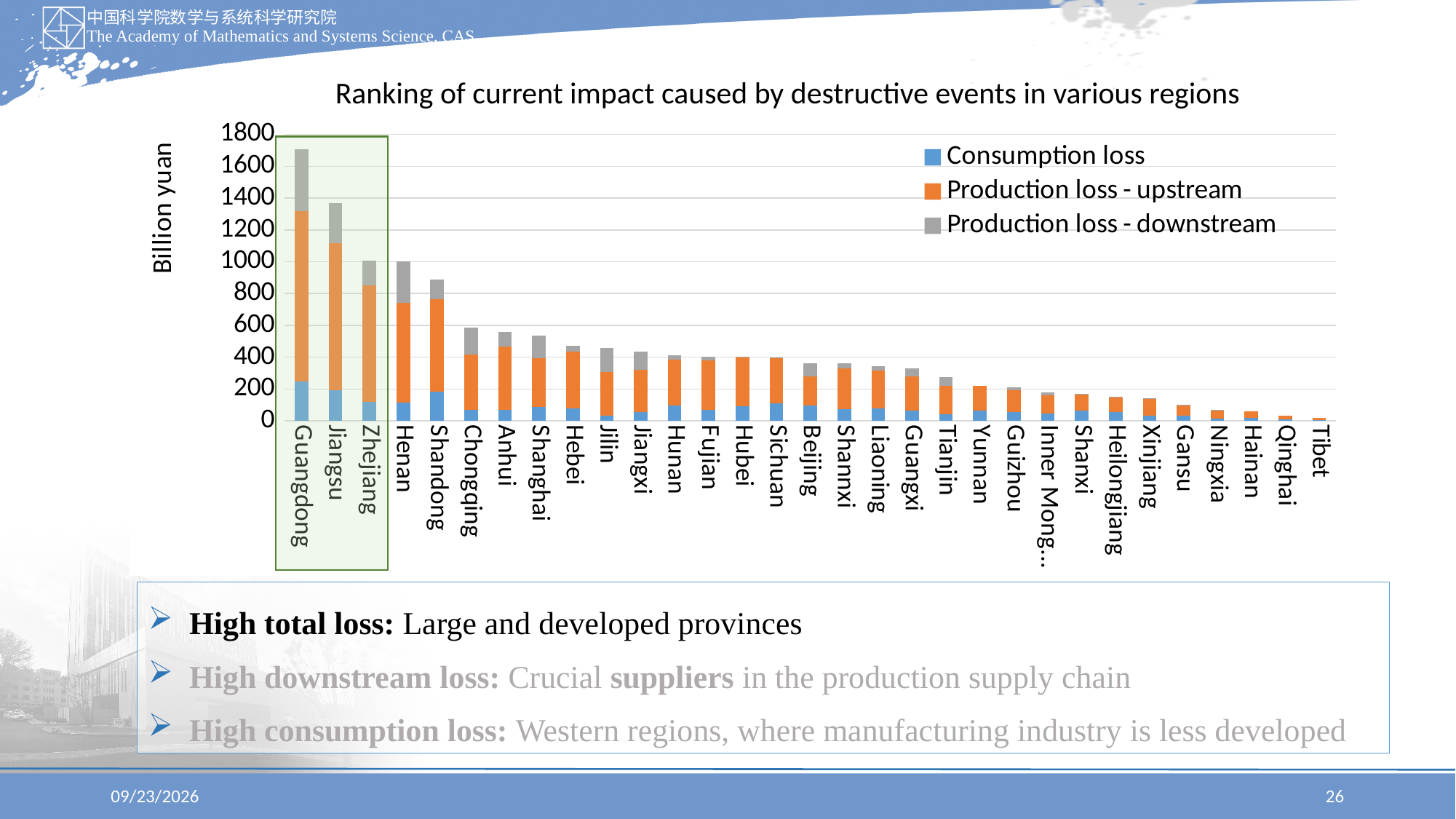
What unit is shown on the vertical axis label? Billion yuan Which has a larger total loss, Guangdong or Jiangsu? Guangdong What is the title of the chart? Ranking of current impact caused by destructive events in various regions How many series does the legend list? 3 Is the total loss for Jiangsu greater or less than 1200 billion yuan? greater Is the total loss for Tibet greater or less than 200 billion yuan? less What kind of chart is shown on the slide? stacked bar chart Is the total loss for Shandong greater or less than 800 billion yuan? greater Do the total losses rise or fall moving from left to right along the x axis? fall Which region has the highest total loss? Guangdong Which region has the lowest total loss? Tibet